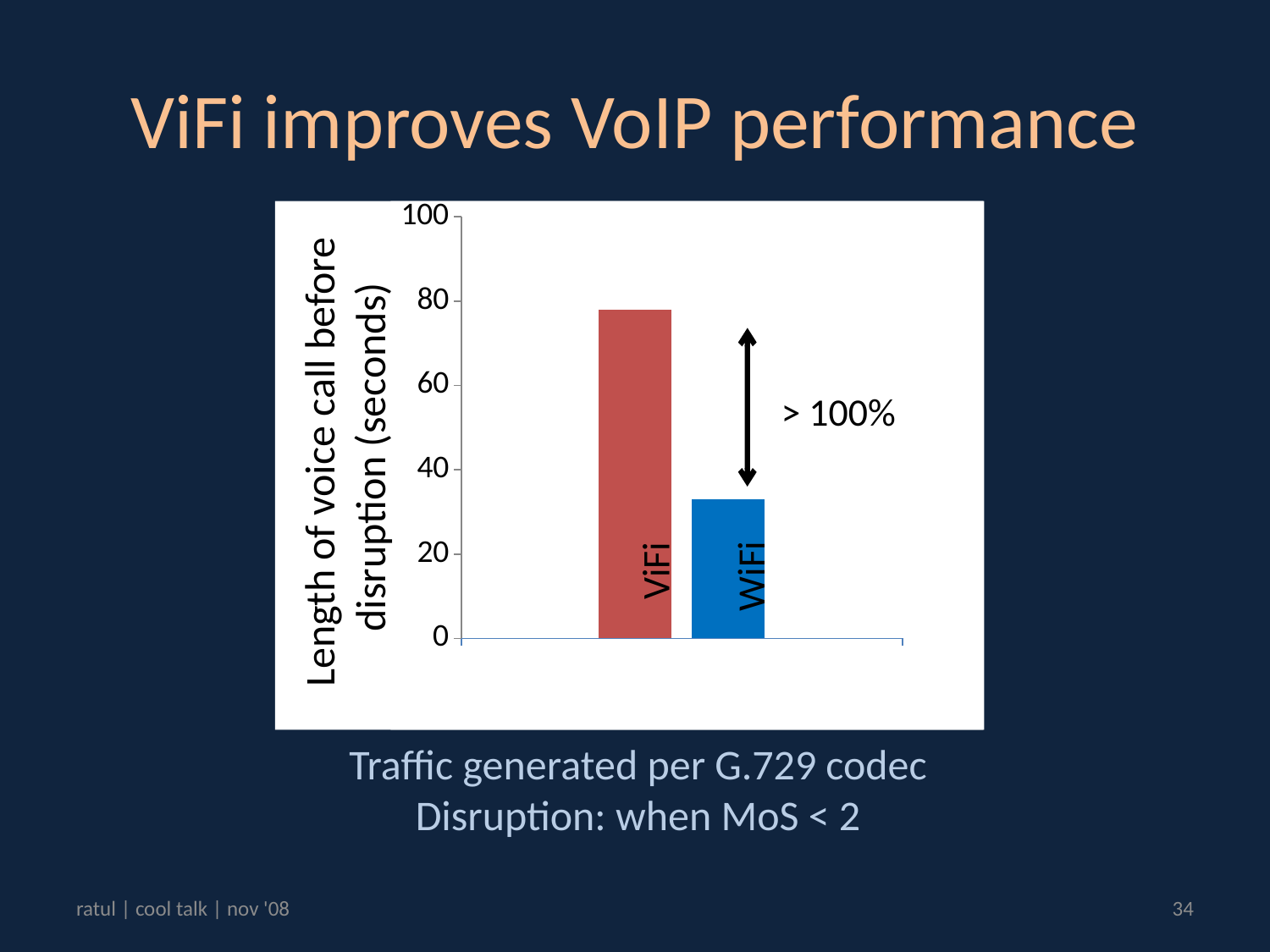
How many bars are plotted in the chart? 2 Which bar is the highest in the chart? ViFi What is the label on the vertical axis of the chart? Length of voice call before disruption (seconds) Which has a longer voice call before disruption, ViFi or WiFi? ViFi What improvement is annotated next to the arrow between the two bars? > 100% Which bar is the lowest in the chart? WiFi Is the value for ViFi greater or less than 60? greater Is the value for WiFi greater or less than 20? greater Is the value for WiFi greater or less than 40? less What kind of chart is shown on the slide? bar chart